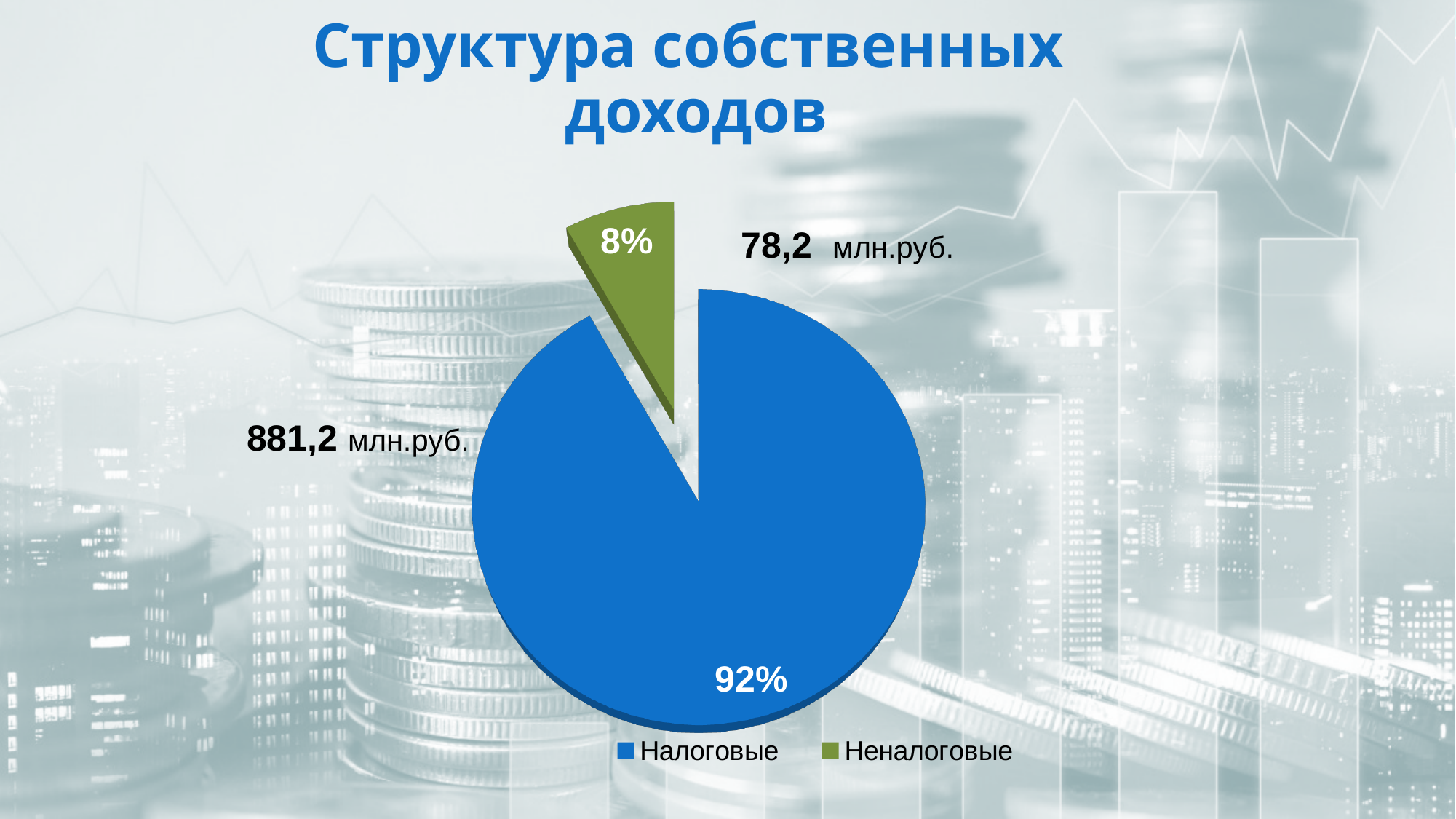
What is the combined value of the Налоговые and Неналоговые slices in млн.руб.? 959,4 млн.руб. Which category has the largest slice of the pie? Налоговые What value in млн.руб. is shown for the Неналоговые slice? 78,2 млн.руб. Which category has the smallest slice of the pie? Неналоговые What is the title of the chart on the slide? Структура собственных доходов How many slices does the pie chart have? 2 What share of the pie does the Неналоговые slice represent? 8% What type of chart is shown on the slide? Pie chart Which is larger, the Налоговые slice or the Неналоговые slice? Налоговые What share of the pie does the Налоговые slice represent? 92% What value in млн.руб. is shown for the Налоговые slice? 881,2 млн.руб. What is the difference in percentage points between the Налоговые and Неналоговые shares? 84%